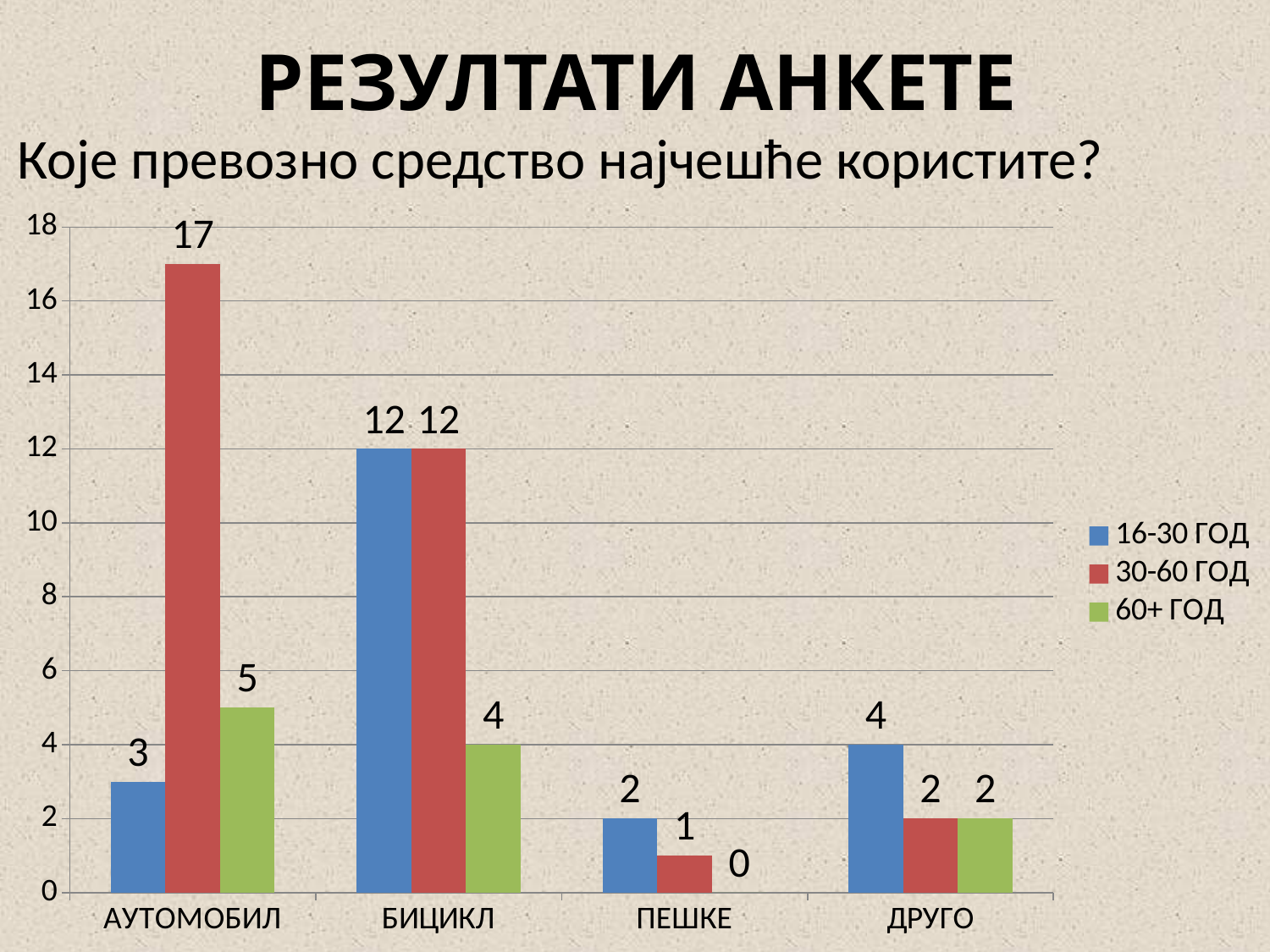
How many series does the legend list? 3 What is the value for 30-60 ГОД in the АУТОМОБИЛ category? 17 What is the difference between the 30-60 ГОД and 16-30 ГОД values in the АУТОМОБИЛ category? 14 Which category has the lowest value for the 60+ ГОД series? ПЕШКЕ What kind of chart is shown on the slide? bar chart What is the value for 16-30 ГОД in the ДРУГО category? 4 How many categories are shown on the x axis? 4 What is the total of the three series in the БИЦИКЛ category? 28 Which colour represents the 60+ ГОД series in the legend? green Which is larger in the ПЕШКЕ category: the 16-30 ГОД value or the 30-60 ГОД value? 16-30 ГОД What is the value for 60+ ГОД in the БИЦИКЛ category? 4 Which category has the highest value for the 30-60 ГОД series? АУТОМОБИЛ